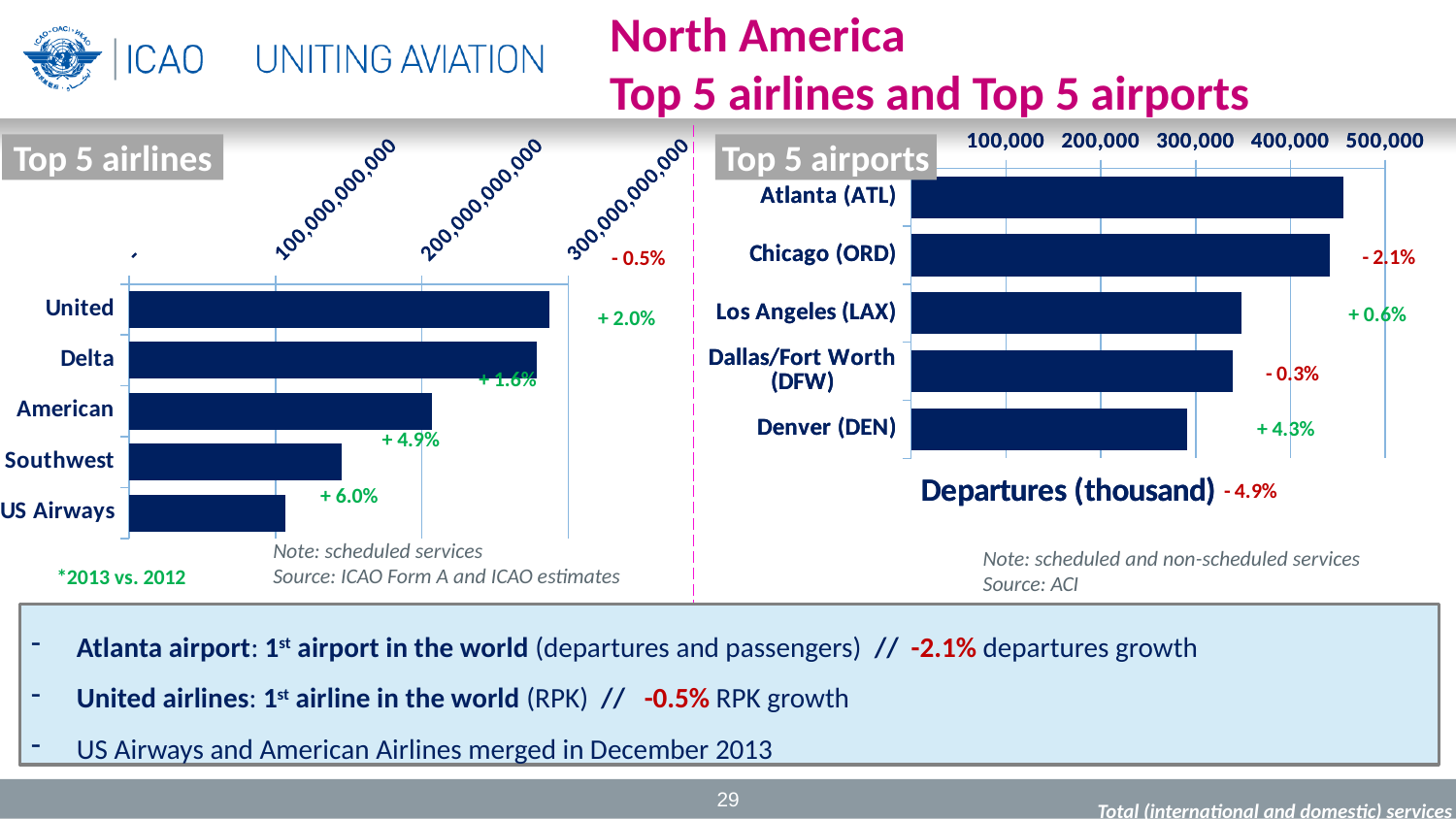
In the Top 5 airlines chart, which has the larger value, Delta or American? Delta In the Top 5 airlines chart, is the value for American greater or less than 300,000,000,000? less In the Top 5 airports chart, is the value for Denver (DEN) greater or less than 400,000? less In the Top 5 airlines chart, which airline has the longest bar? United What is the departures growth shown for Atlanta airport on the slide? -2.1% In the Top 5 airlines chart, is the value for Southwest greater or less than 100,000,000,000? greater What kind of chart is the Top 5 airlines chart? bar chart How many airlines are shown in the Top 5 airlines chart? 5 In the Top 5 airports chart, which airport has the shortest bar? Denver (DEN) In the Top 5 airlines chart, which airline has the shortest bar? US Airways What is the axis label shown below the bars in the Top 5 airports chart? Departures (thousand)